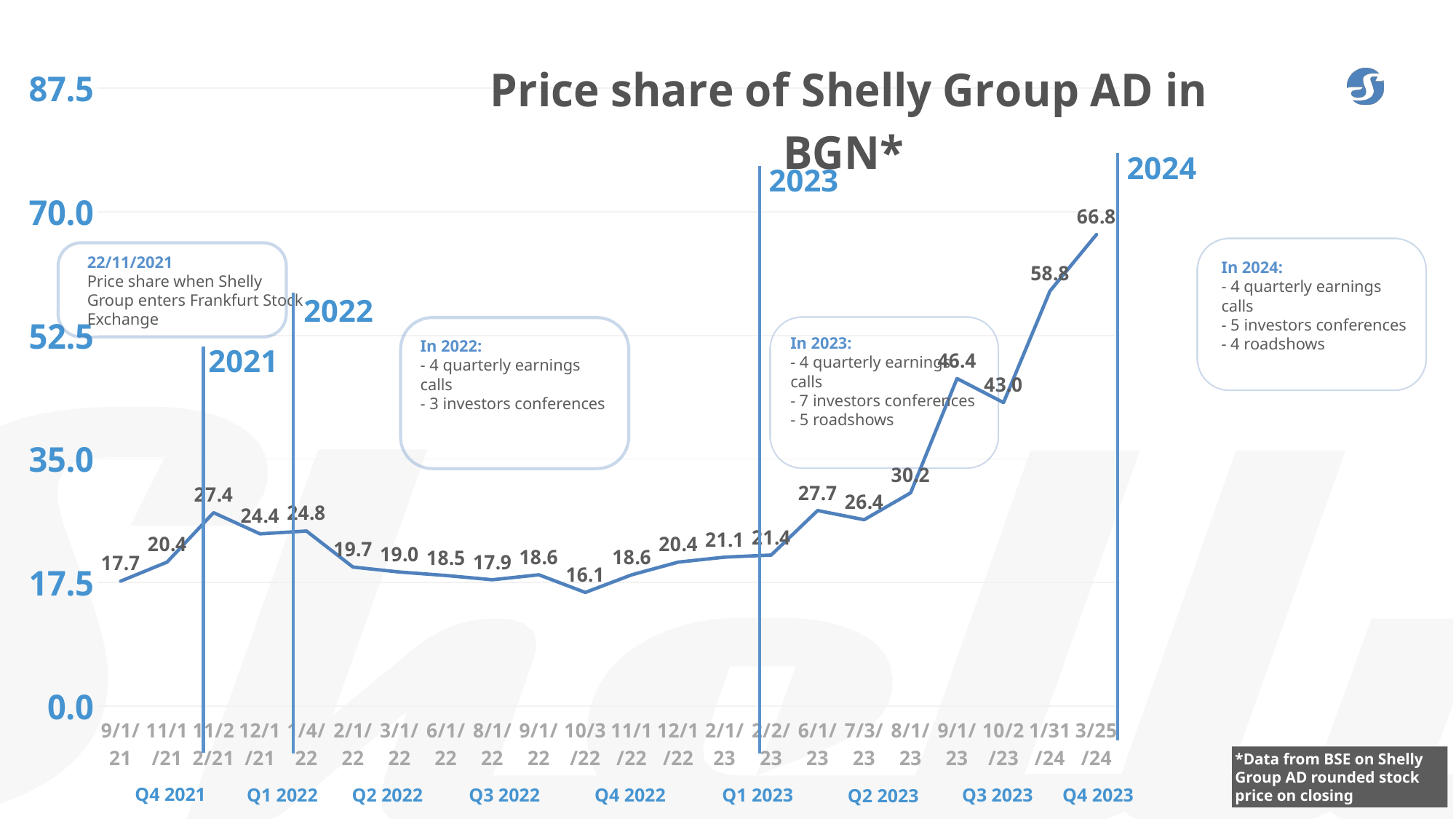
What type of chart is shown on the slide? line chart What is the price share value at 3/25/24? 66.8 What is the difference between the price share at 3/25/24 and at 1/31/24? 8.0 Is the price share at 1/31/24 greater or less than 52.5? greater At which date is the price share highest? 3/25/24 What is the price share value at 9/1/23? 46.4 How many data points are plotted on the line? 22 At which date is the price share lowest? 10/3/22 What is the price share value at 10/3/22? 16.1 What is the title of the chart? Price share of Shelly Group AD in BGN* What is the price share value at 11/22/21? 27.4 Which is larger, the price share at 9/1/23 or at 10/2/23? 9/1/23